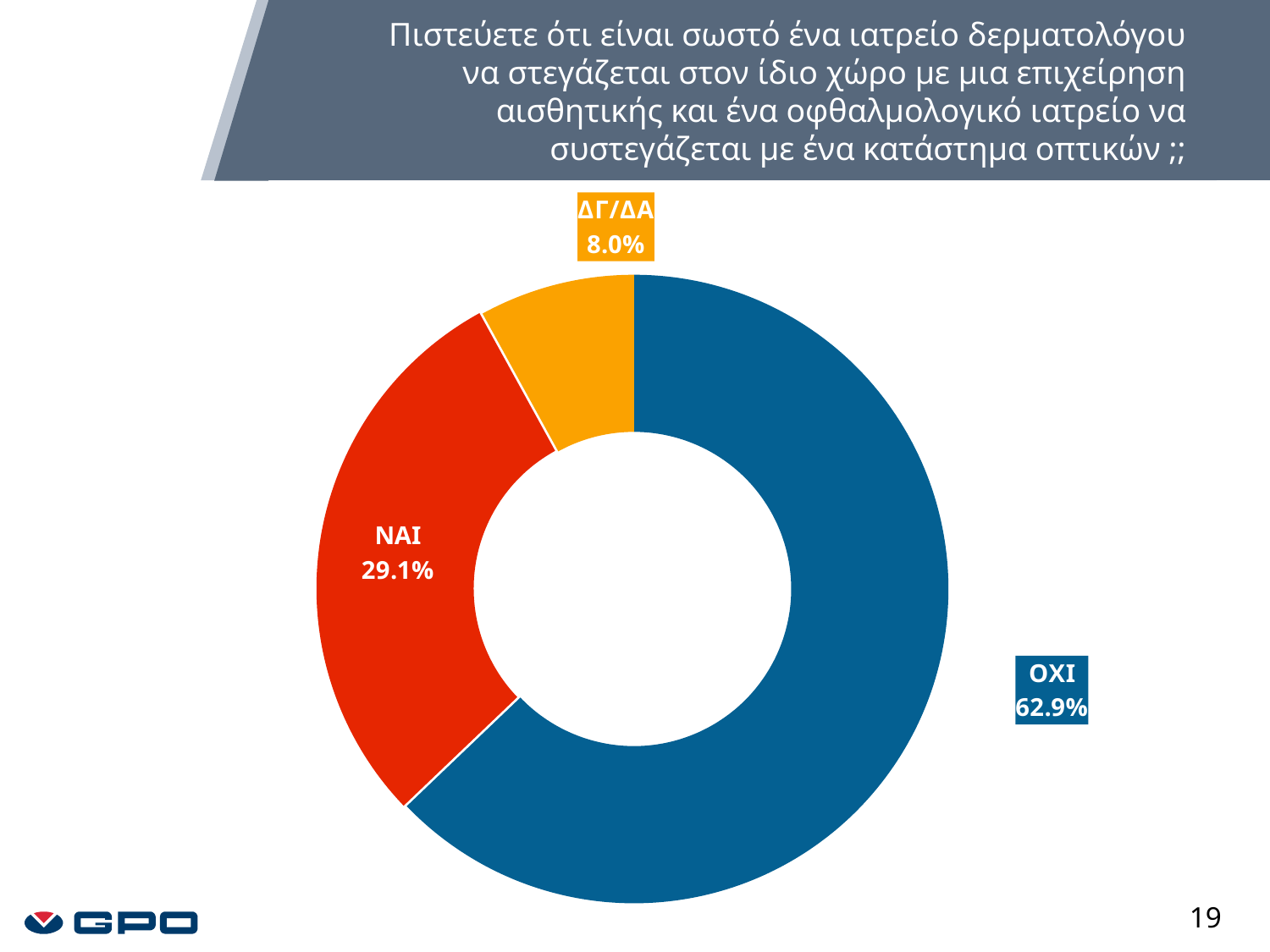
What is the value shown for ΔΓ/ΔΑ? 8.0% How many categories are shown in the chart? 3 What colour is the ΔΓ/ΔΑ segment of the chart? Orange What is the difference in percentage points between ΝΑΙ and ΔΓ/ΔΑ? 21.1 Which is larger, the share for ΝΑΙ or the share for ΟΧΙ? ΟΧΙ What percentage of respondents answered ΟΧΙ? 62.9% What colour is the ΝΑΙ segment of the chart? Red What is the difference in percentage points between ΟΧΙ and ΝΑΙ? 33.8 What type of chart is shown on the slide? Doughnut (pie) chart Which response has the smallest share of the chart? ΔΓ/ΔΑ What percentage of respondents answered ΝΑΙ? 29.1% Which response has the largest share of the chart? ΟΧΙ